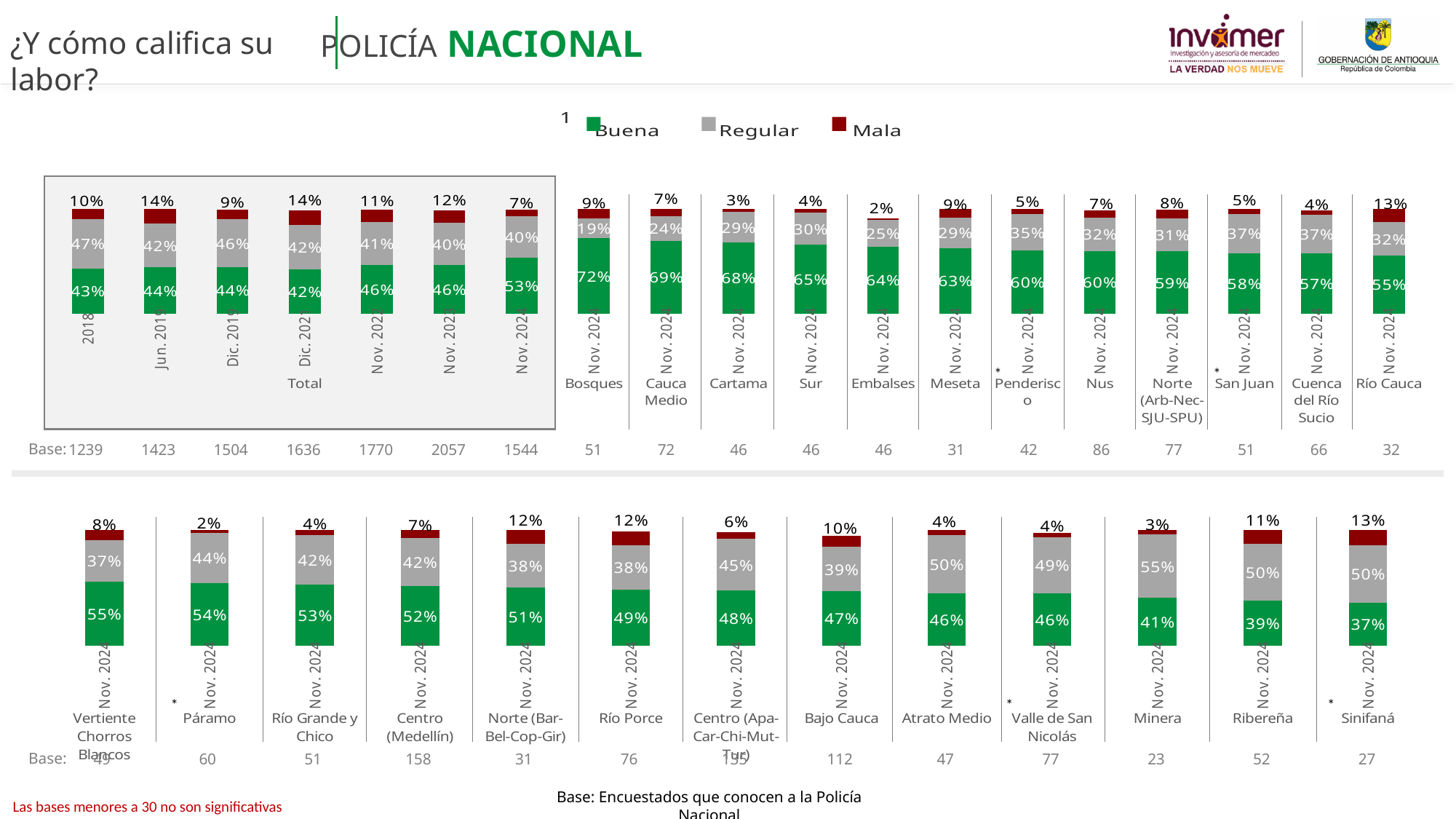
What kind of chart is used on this slide? Stacked bar chart In the bottom chart, which region has the lowest Buena percentage? Sinifaná In the top chart, what percentage of respondents rated the Policía Nacional's work as Buena in Bosques? 72% In the top chart's Total series, what is the Mala percentage for Nov. 2024? 7% In the bottom chart, what is the Regular percentage for Minera? 55% In the top chart's Total series, by how many percentage points did the Buena share change from 2018 to Nov. 2024? 10 percentage points In the top chart, which region (excluding the Total series) has the highest Buena percentage? Bosques How many series does the legend list? 3 In the top chart, which has a higher Buena percentage, Cartama or Sur? Cartama In the bottom chart, what is the Mala percentage for Páramo? 2% Which colour represents the Mala series in the legend? Dark red In the top chart's Total series, does the Buena percentage rise or fall from Nov. 2022 to Nov. 2024? Rises